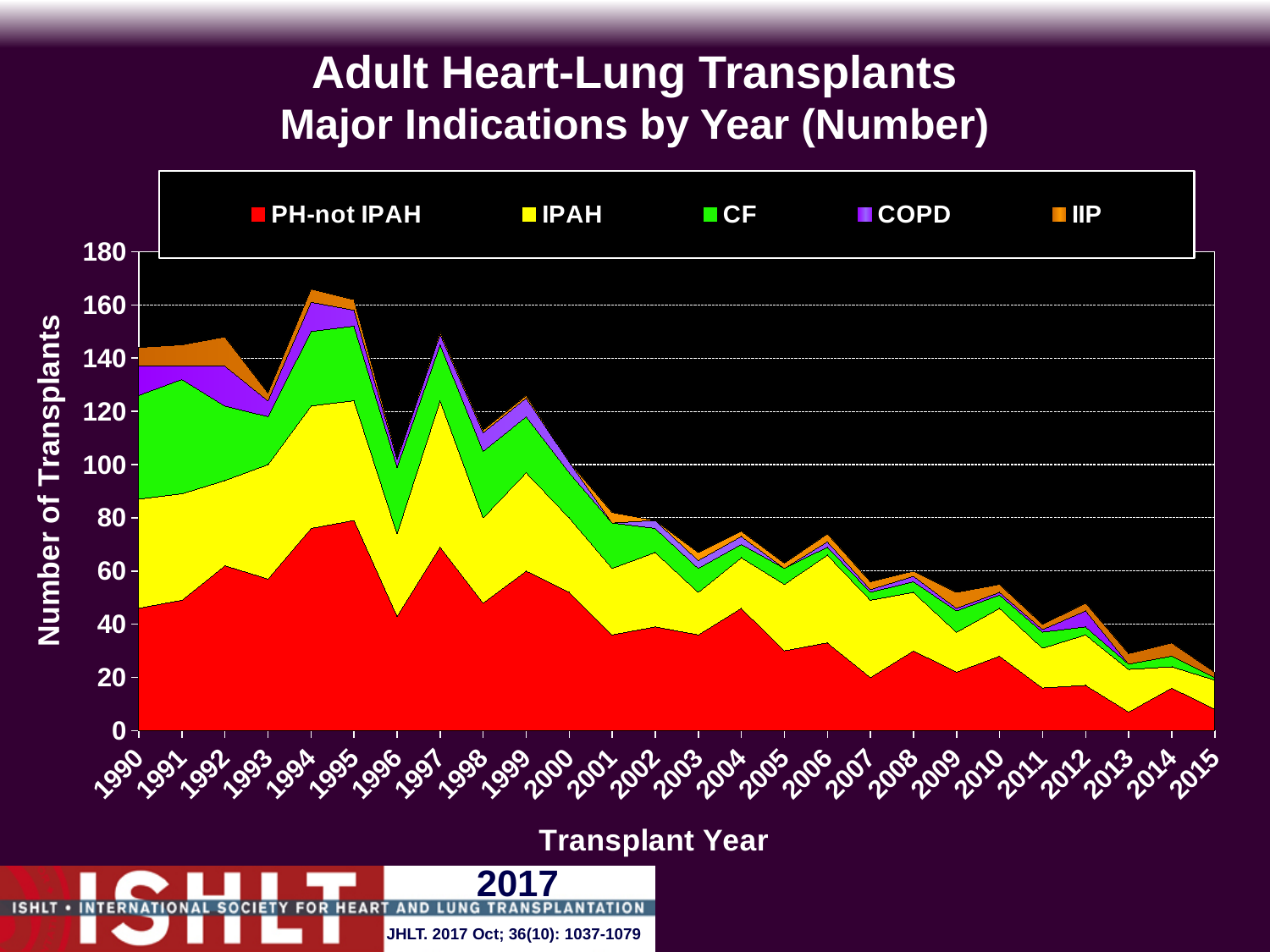
Is the total number of transplants in 1996 greater or less than 120? less Which year has a larger total number of transplants, 1994 or 2004? 1994 Does the total number of transplants generally rise or fall from 1990 to 2015? Fall Which colour represents CF in the chart? Green Is the total number of transplants in 2015 greater or less than 40? less What kind of chart is shown on the slide? Stacked area chart Is the total number of transplants in 2005 greater or less than 80? less Which transplant year has the highest total number of transplants? 1994 How many transplant years are shown along the x axis? 26 What is the title of the chart? Adult Heart-Lung Transplants Major Indications by Year (Number) How many series does the legend list? 5